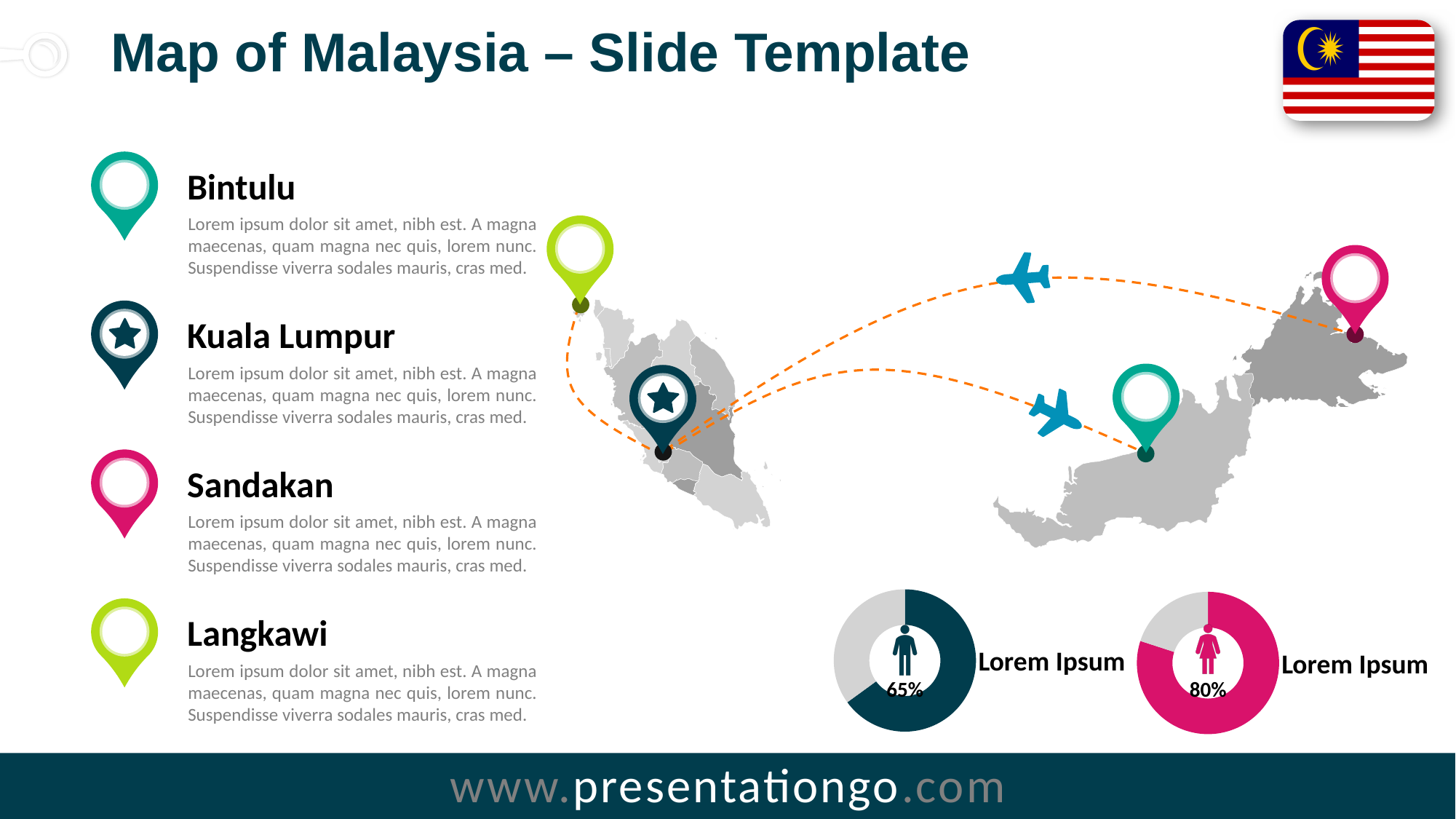
What is the difference between the percentage in the female-icon donut chart and the percentage in the male-icon donut chart? 15% What colour is the filled portion of the donut chart with the female figure icon? pink In the donut chart with the male figure icon, what percentage is printed in the centre? 65% In the donut chart with the male figure icon, is the filled share greater or less than 50%? greater In the donut chart with the female figure icon, is the filled share greater or less than 75%? greater In the donut chart with the female figure icon, what share of the ring is left grey? 20% How many donut charts are shown at the bottom right of the slide? 2 What kind of chart is shown at the bottom right of the slide next to the male figure icon? donut chart In the donut chart with the female figure icon, what percentage is printed in the centre? 80% In the donut chart with the male figure icon, what share of the ring is not filled with the dark colour? 35% Which of the two donut charts at the bottom right shows the larger percentage, the one with the male icon or the one with the female icon? the one with the female icon What label text appears to the right of each donut chart at the bottom of the slide? Lorem Ipsum